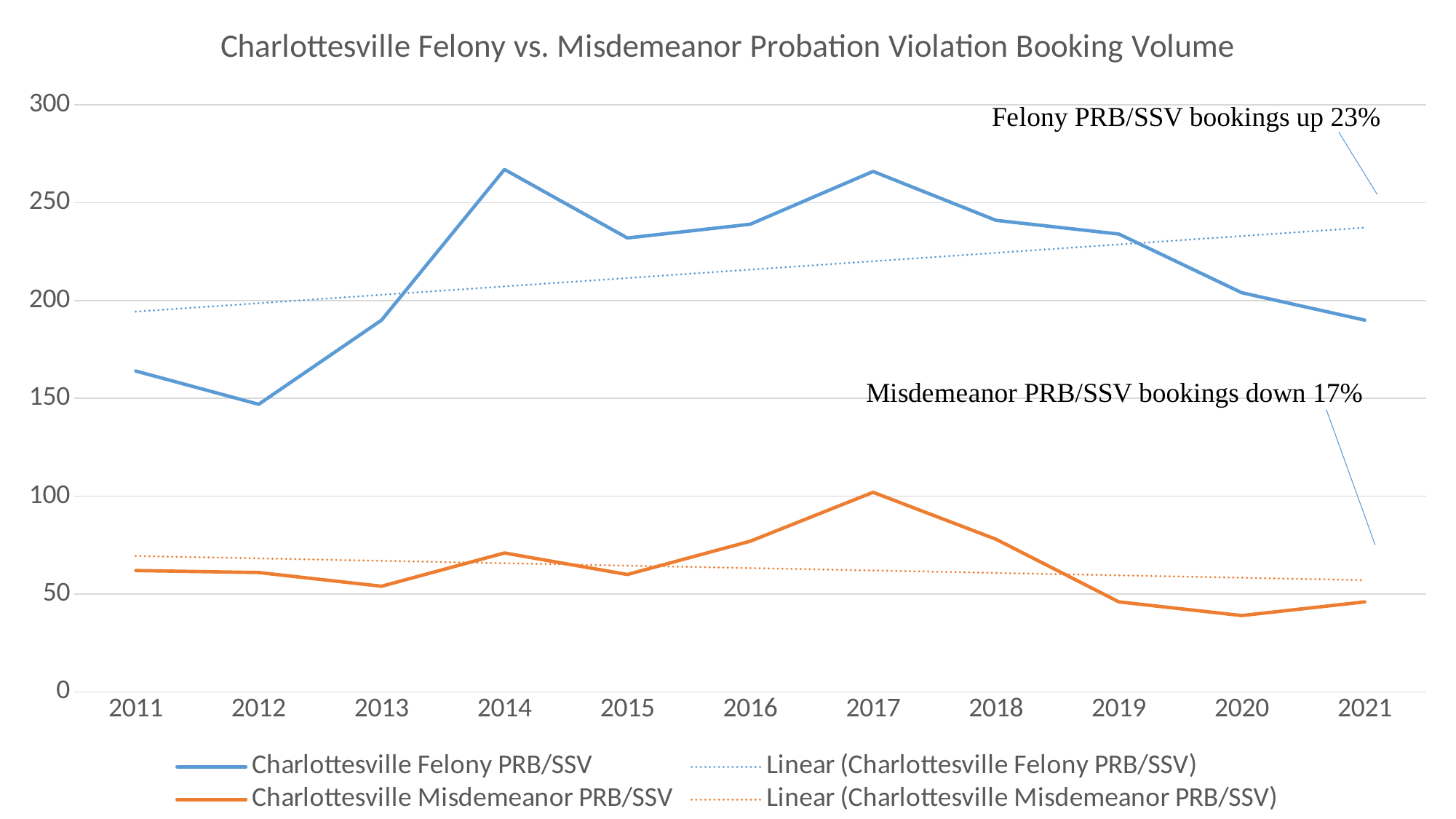
Is the Charlottesville Misdemeanor PRB/SSV value for 2020 greater or less than 50? less How many entries does the legend list? 4 Is the Charlottesville Felony PRB/SSV value for 2014 greater or less than 250? greater In which year is the Charlottesville Felony PRB/SSV line at its lowest? 2012 What is the title of the chart? Charlottesville Felony vs. Misdemeanor Probation Violation Booking Volume Which is larger in 2011: Charlottesville Felony PRB/SSV or Charlottesville Misdemeanor PRB/SSV? Charlottesville Felony PRB/SSV Is the Charlottesville Felony PRB/SSV value for 2021 greater or less than 200? less In which year is the Charlottesville Misdemeanor PRB/SSV line at its lowest? 2020 Does the Charlottesville Misdemeanor PRB/SSV line rise or fall from 2017 to 2020? Fall In which year is the Charlottesville Misdemeanor PRB/SSV line at its highest? 2017 How many years are shown on the x axis? 11 What kind of chart is shown on the slide? Line chart